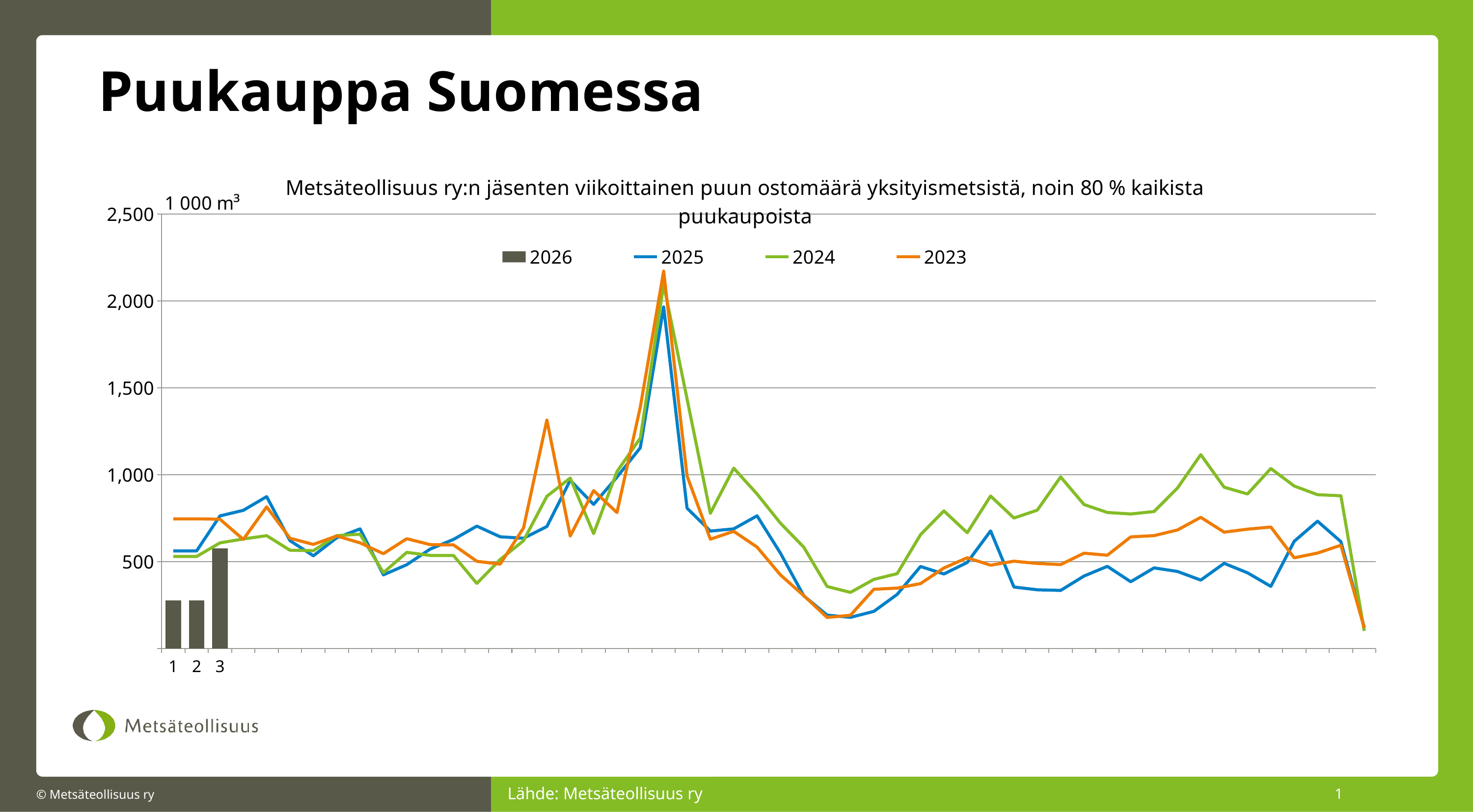
Is the 2026 value for week 3 greater or less than 1,000? less What is the highest value shown on the vertical axis? 2,500 Which series is drawn as bars rather than a line? 2026 What unit is shown for the vertical axis? 1 000 m³ Is the 2026 bar for week 3 higher or lower than the bar for week 1? higher How many bars are plotted for the 2026 series? 3 Is the highest point of the 2025 line greater or less than 1,500? greater Is the highest point of the 2023 line greater or less than 2,000? greater What kind of chart is shown on the slide? A combined bar and line chart How many series does the chart legend list? 4